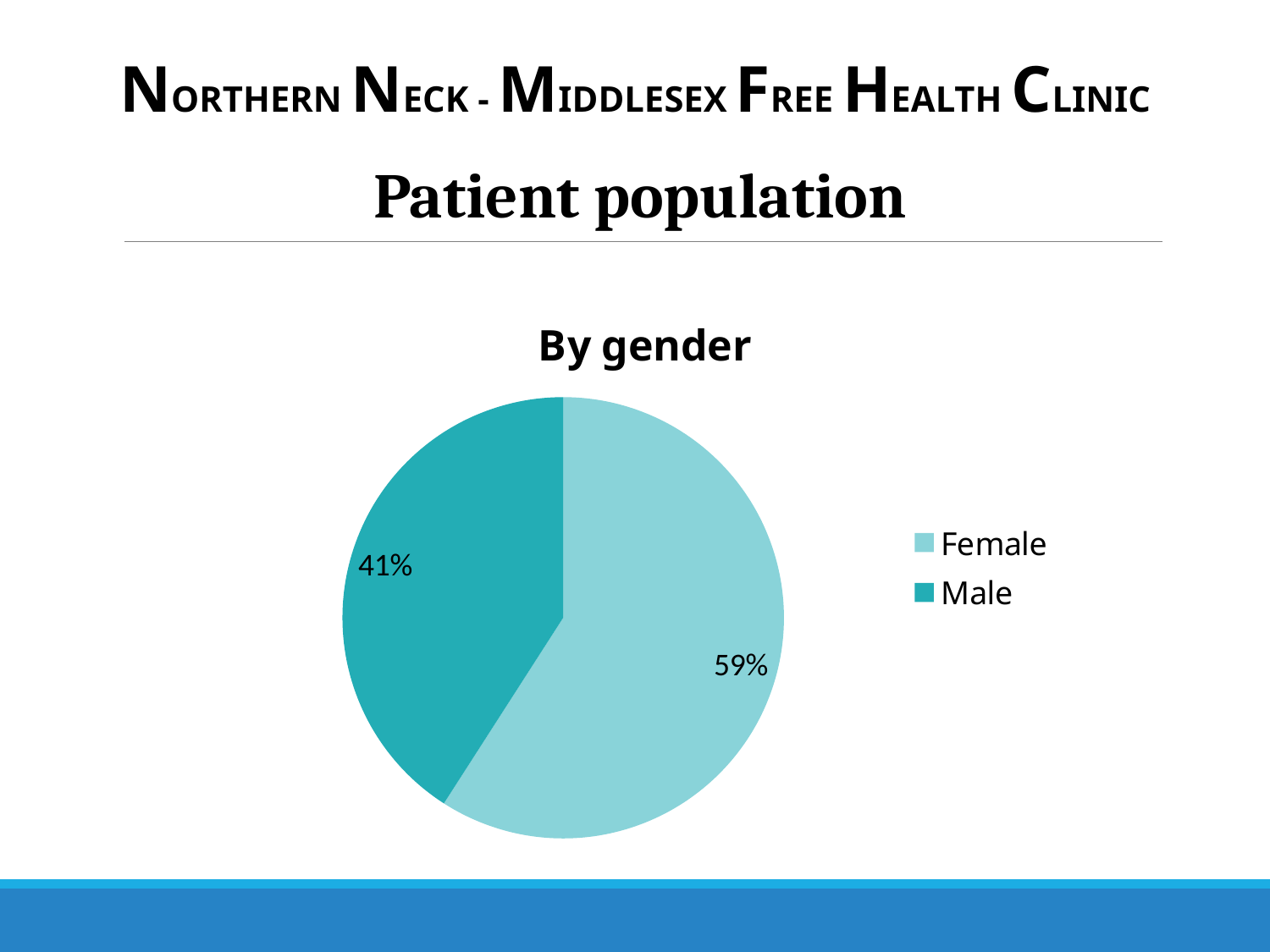
What is the difference in percentage points between the Female and Male shares? 18 How many entries does the legend list? 2 Which gender has the larger share of the patient population? Female How many slices does the pie chart have? 2 What is the title of the chart? By gender Is the Female share larger or smaller than the Male share? larger What share of the pie does the Male slice represent? 41% What kind of chart is shown on the slide? pie chart What percentage of patients are Male? 41% What percentage of patients are Female? 59% Which legend entry is shown in the darker teal colour? Male Which gender has the smaller share of the patient population? Male